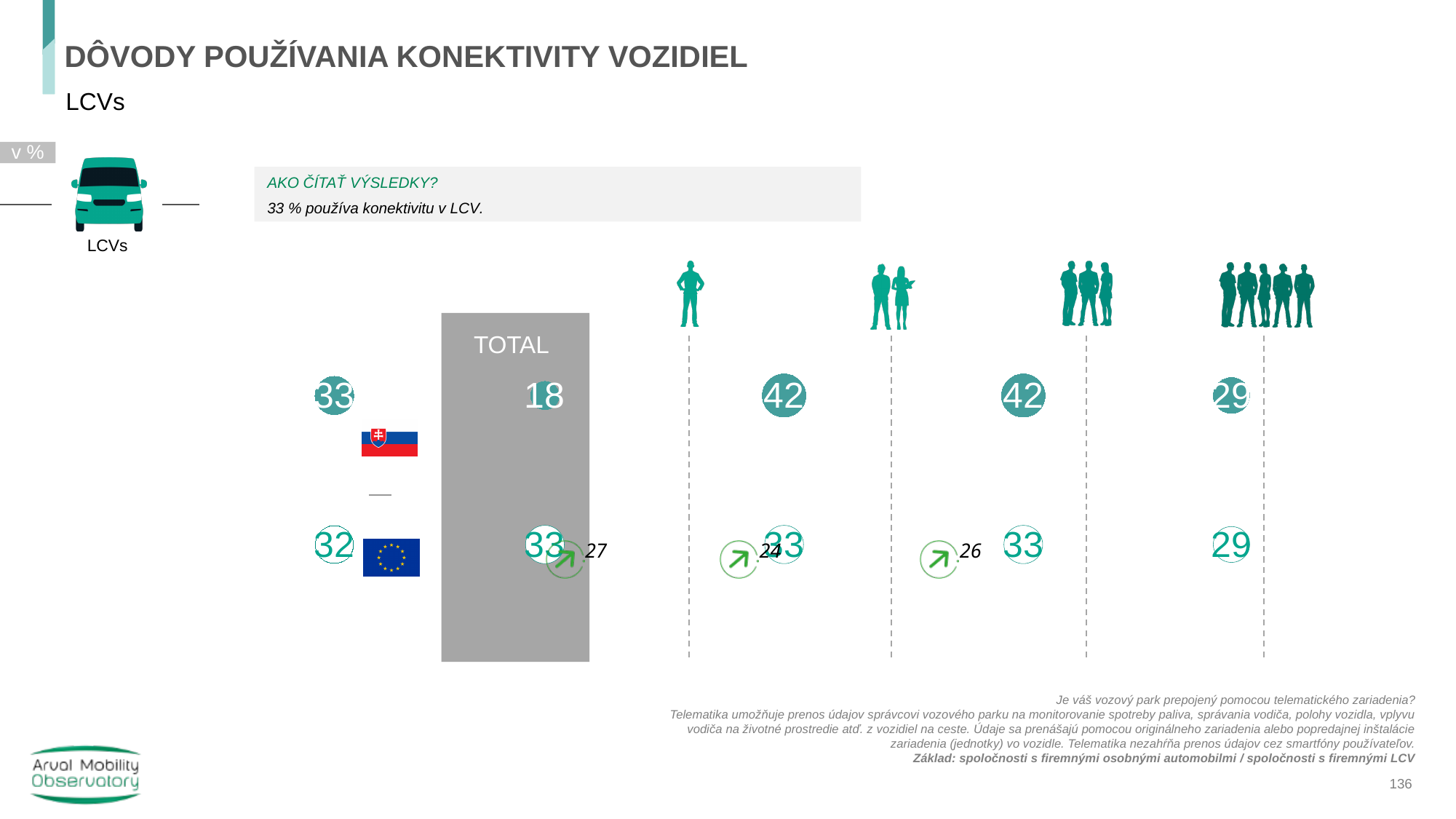
What number is printed next to the green trend arrow beside the TOTAL column's bottom-row value? 27 In the TOTAL column, what value is shown in the top row (next to the Slovak flag)? 18 What is the difference between the top-row value in the single-person column (42) and the TOTAL top-row value (18)? 24 What is the label printed at the top of the grey column? TOTAL What value is shown in the leftmost circle of the top row, beside the Slovak flag? 33 In the column with the single-person icon, what value is shown in the top row? 42 In the top row, which is larger: the TOTAL value or the value in the rightmost (five-person) column? the rightmost column (29) In the rightmost column (five-person icon), what value is shown in the top row? 29 What value is shown in the leftmost circle of the bottom row, beside the EU flag? 32 What unit do the values on this slide represent, according to the tag at the top left? % In the TOTAL column, what value is shown in the bottom row (next to the EU flag)? 33 How many company-size segment columns with person icons are shown to the right of the TOTAL column? 4